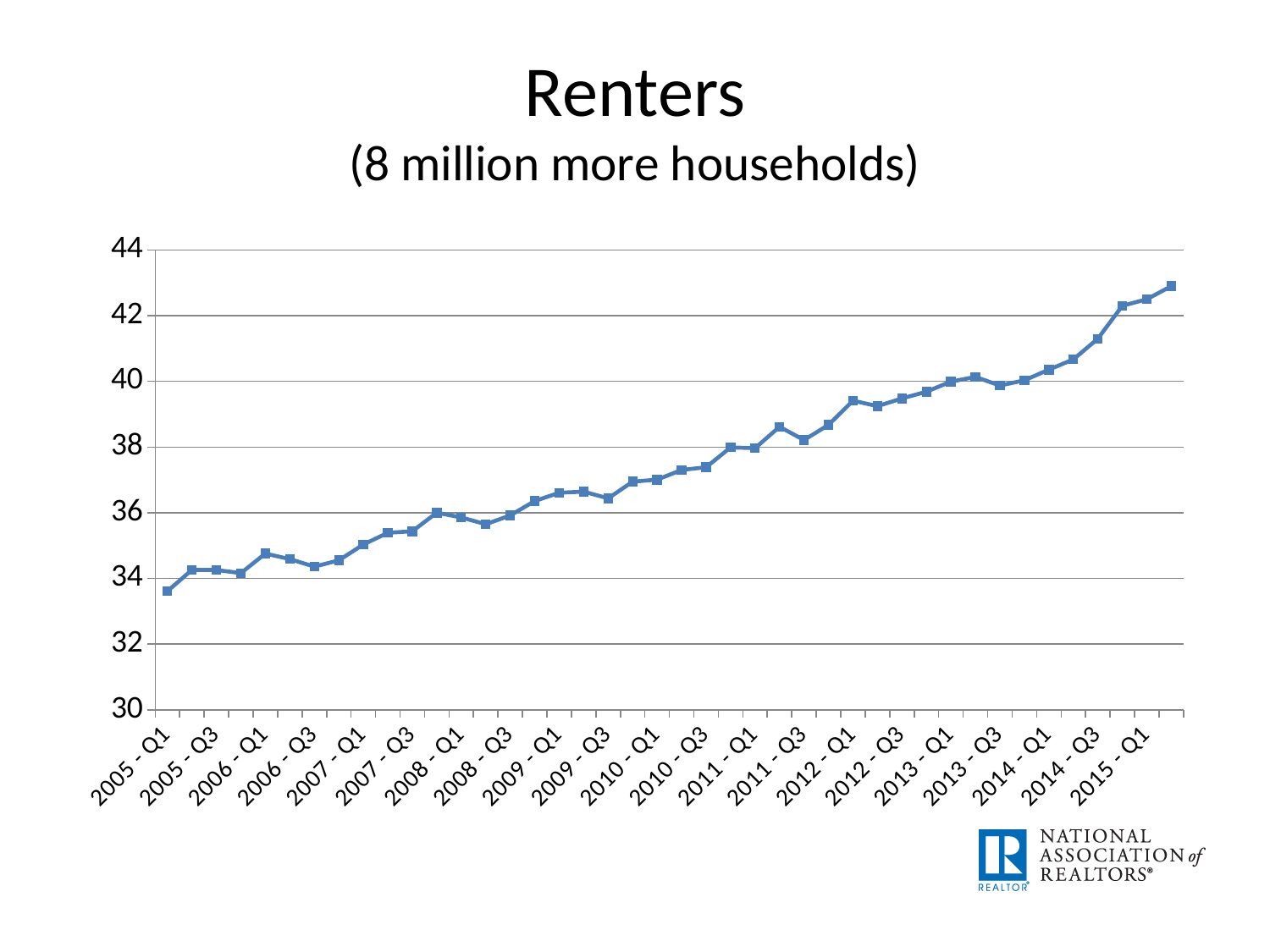
Is the value for 2015 - Q1 greater or less than 42? greater Which labelled quarter has the lowest value on the chart? 2005 - Q1 Which is larger, the value for 2008 - Q1 or the value for 2012 - Q1? 2012 - Q1 Do the values generally rise or fall from 2005 - Q1 to 2015 - Q1? rise What is the title of the chart? Renters What does the subtitle under the chart title say? (8 million more households) Is the value for 2007 - Q1 greater or less than 36? less What kind of chart is shown on the slide? line chart Is the value for 2010 - Q1 greater or less than 36? greater Which is larger, the value for 2015 - Q1 or the value for 2005 - Q1? 2015 - Q1